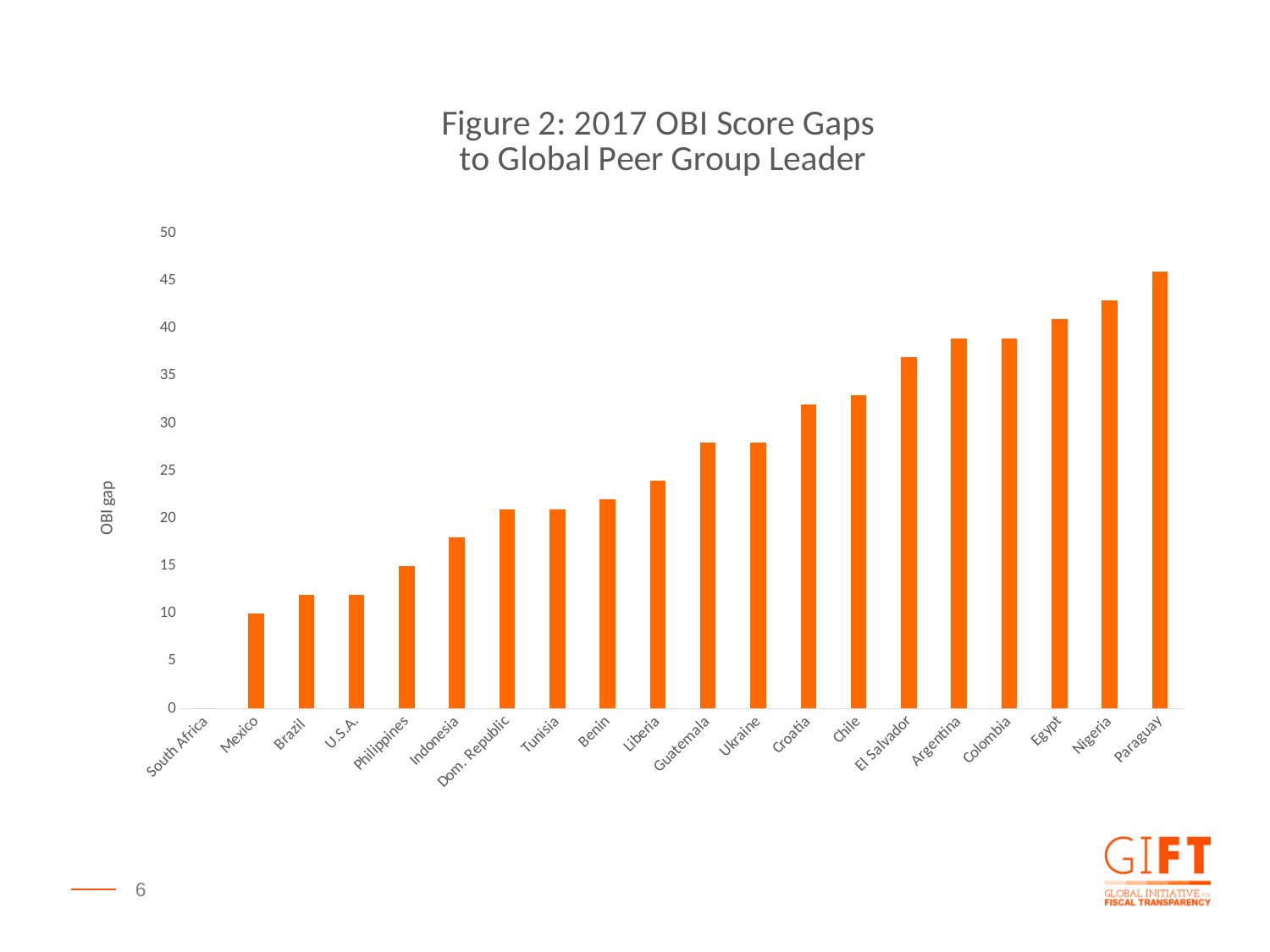
Is the value for Paraguay greater or less than 40? greater Is the value for Mexico greater or less than 15? less Is the value for Nigeria greater or less than 40? greater Do the values rise or fall moving from left to right along the x axis? rise Which has a larger OBI gap, Croatia or Mexico? Croatia What kind of chart is shown on the slide? bar chart How many countries are shown on the x axis of the chart? 20 Which country has the largest OBI gap in the chart? Paraguay Which country has the smallest OBI gap in the chart? South Africa What is the label on the vertical axis of the chart? OBI gap